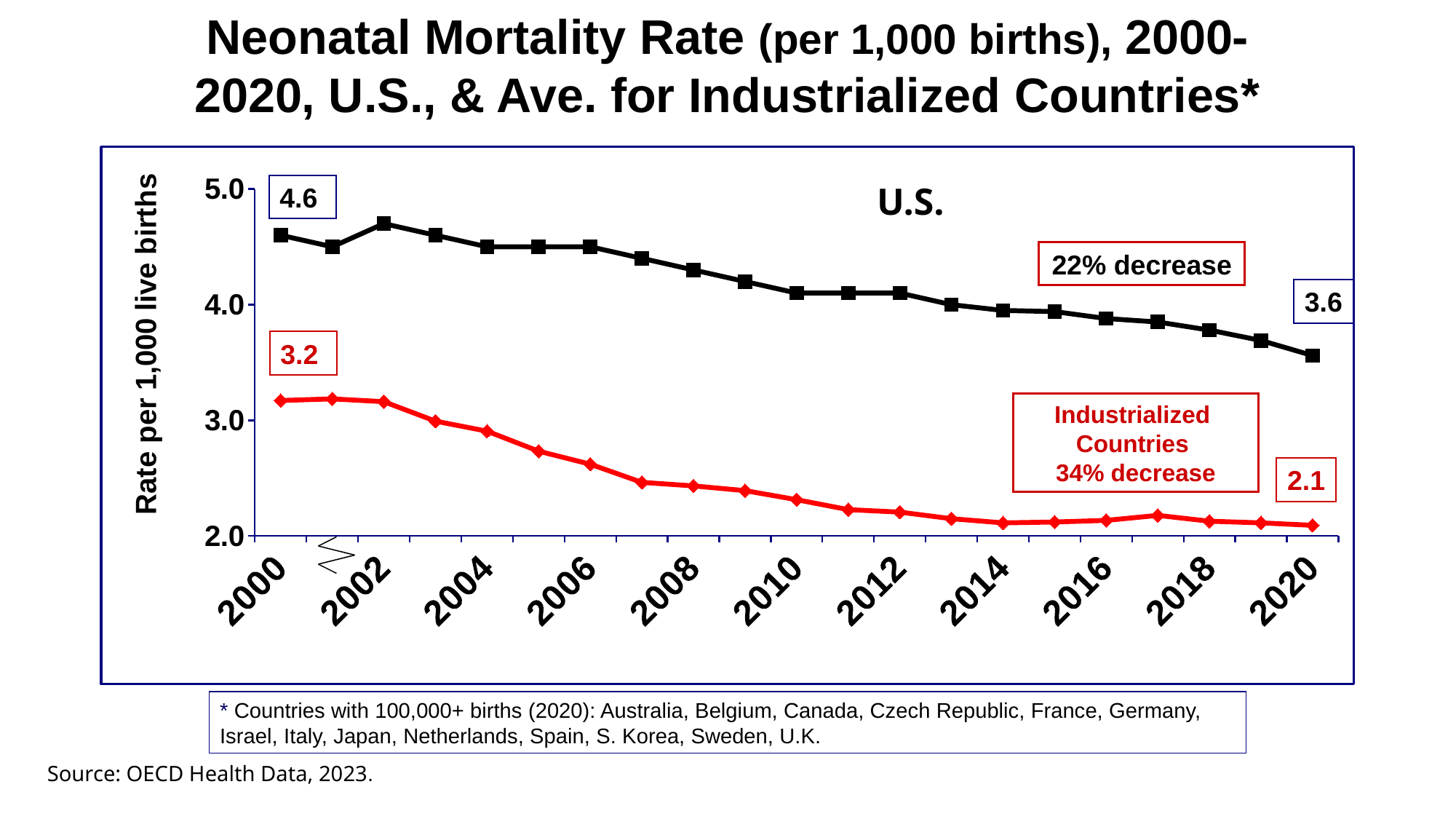
In 2020, how much higher was the U.S. rate than the industrialized countries average? 1.5 By how much did the U.S. neonatal mortality rate fall between 2000 and 2020? 1.0 What was the average neonatal mortality rate for industrialized countries in 2020? 2.1 Is the industrialized countries value for 2006 greater or less than 3.0? less What percentage decrease is shown for the industrialized countries? 34% decrease What kind of chart is shown on the slide? line chart What was the U.S. neonatal mortality rate in 2000? 4.6 Is the U.S. value for 2002 greater or less than 4.0? greater Which was higher in 2020, the U.S. rate or the industrialized countries average? U.S. Do the neonatal mortality rates rise or fall from 2000 to 2020? fall What was the average neonatal mortality rate for industrialized countries in 2000? 3.2 What was the U.S. neonatal mortality rate in 2020? 3.6